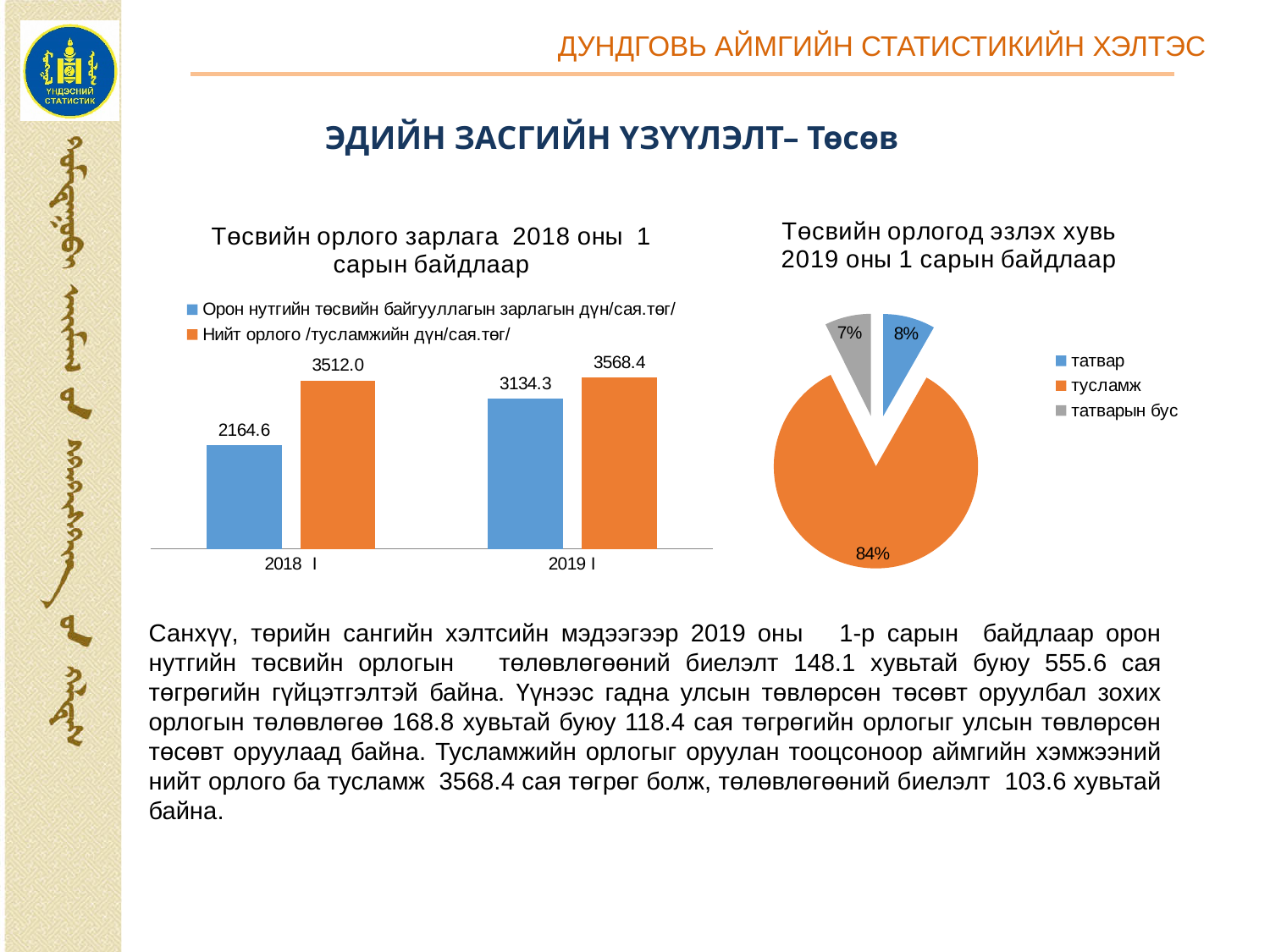
In the bar chart on the left, what is the value of 'Нийт орлого /тусламжийн дүн/сая.төг/' for 2019 I? 3568.4 In the bar chart on the left, how many series does the legend list? 2 In the pie chart on the right, what share does 'татвар' have? 8% In the bar chart on the left, what is the value of 'Орон нутгийн төсвийн байгууллагын зарлагын дүн/сая.төг/' for 2019 I? 3134.3 In the bar chart on the left, what is the difference between the 'Нийт орлого /тусламжийн дүн/сая.төг/' values for 2019 I and 2018 I? 56.4 In the pie chart on the right, which category has the smallest share? татварын бус In the bar chart on the left, what is the value of 'Орон нутгийн төсвийн байгууллагын зарлагын дүн/сая.төг/' for 2018 I? 2164.6 In the bar chart on the left, which is larger for 2018 I: 'Орон нутгийн төсвийн байгууллагын зарлагын дүн/сая.төг/' or 'Нийт орлого /тусламжийн дүн/сая.төг/'? Нийт орлого /тусламжийн дүн/сая.төг/ What kind of chart is the chart on the left of the slide? bar chart In the bar chart on the left, does the 'Орон нутгийн төсвийн байгууллагын зарлагын дүн/сая.төг/' series rise or fall from 2018 I to 2019 I? rise In the pie chart on the right, what share does 'тусламж' have? 84% In the pie chart on the right, how many slices are there? 3